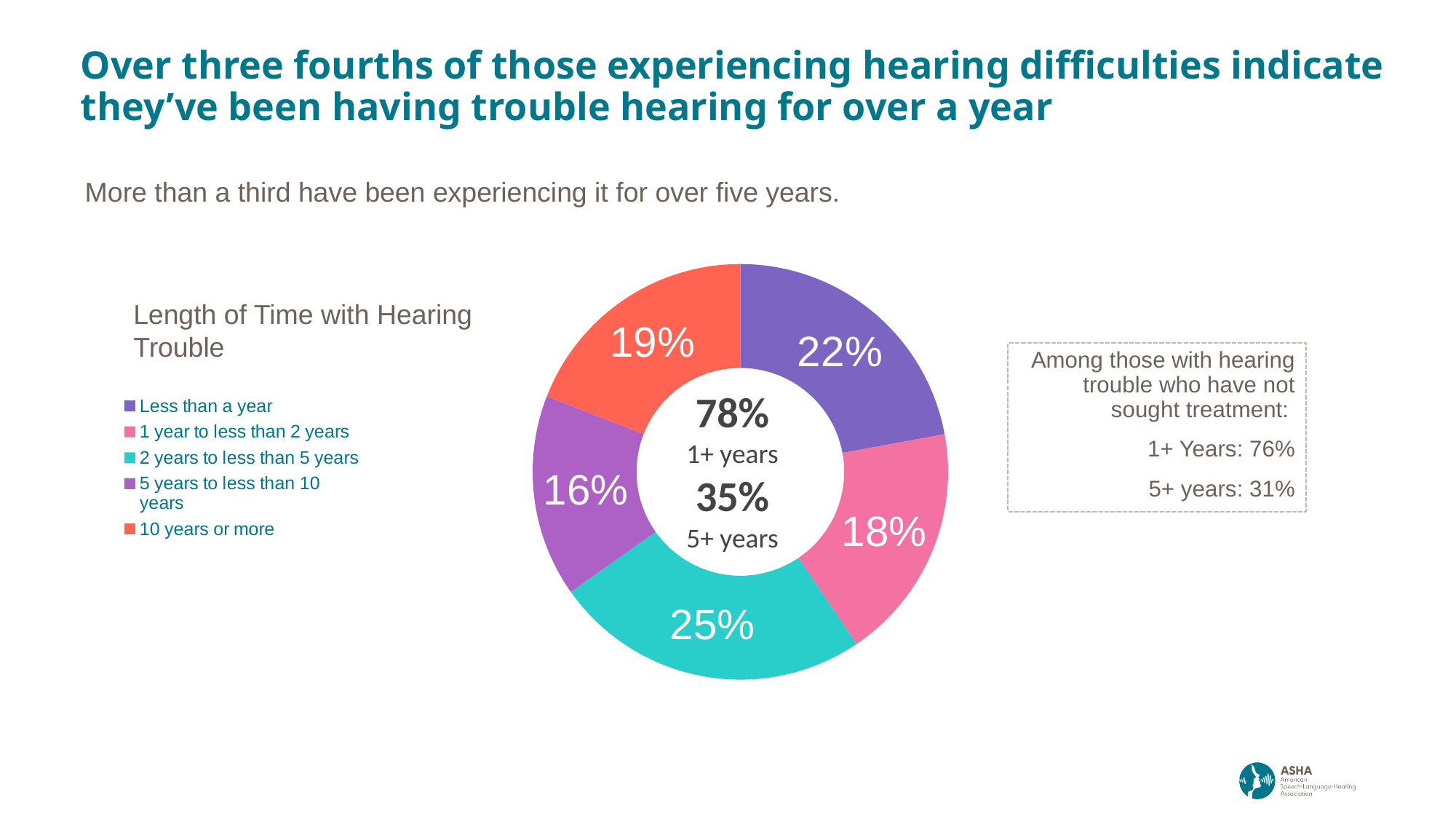
Which length-of-time category has the smallest share of the pie? 5 years to less than 10 years What percentage of respondents have had hearing trouble for 5 years to less than 10 years? 16% What percentage of respondents have had hearing trouble for 10 years or more? 19% What percentage of respondents have had hearing trouble for less than a year? 22% What percentage of respondents have had hearing trouble for 2 years to less than 5 years? 25% Which is larger: the share for 'Less than a year' or the share for '10 years or more'? Less than a year What type of chart is shown on the slide? Doughnut chart What is the title of the chart? Length of Time with Hearing Trouble How many categories does the pie chart show? 5 According to the text in the centre of the chart, what percentage have had hearing trouble for 5+ years? 35% Which length-of-time category has the largest share of the pie? 2 years to less than 5 years What is the difference in percentage points between the '2 years to less than 5 years' slice and the '1 year to less than 2 years' slice? 7